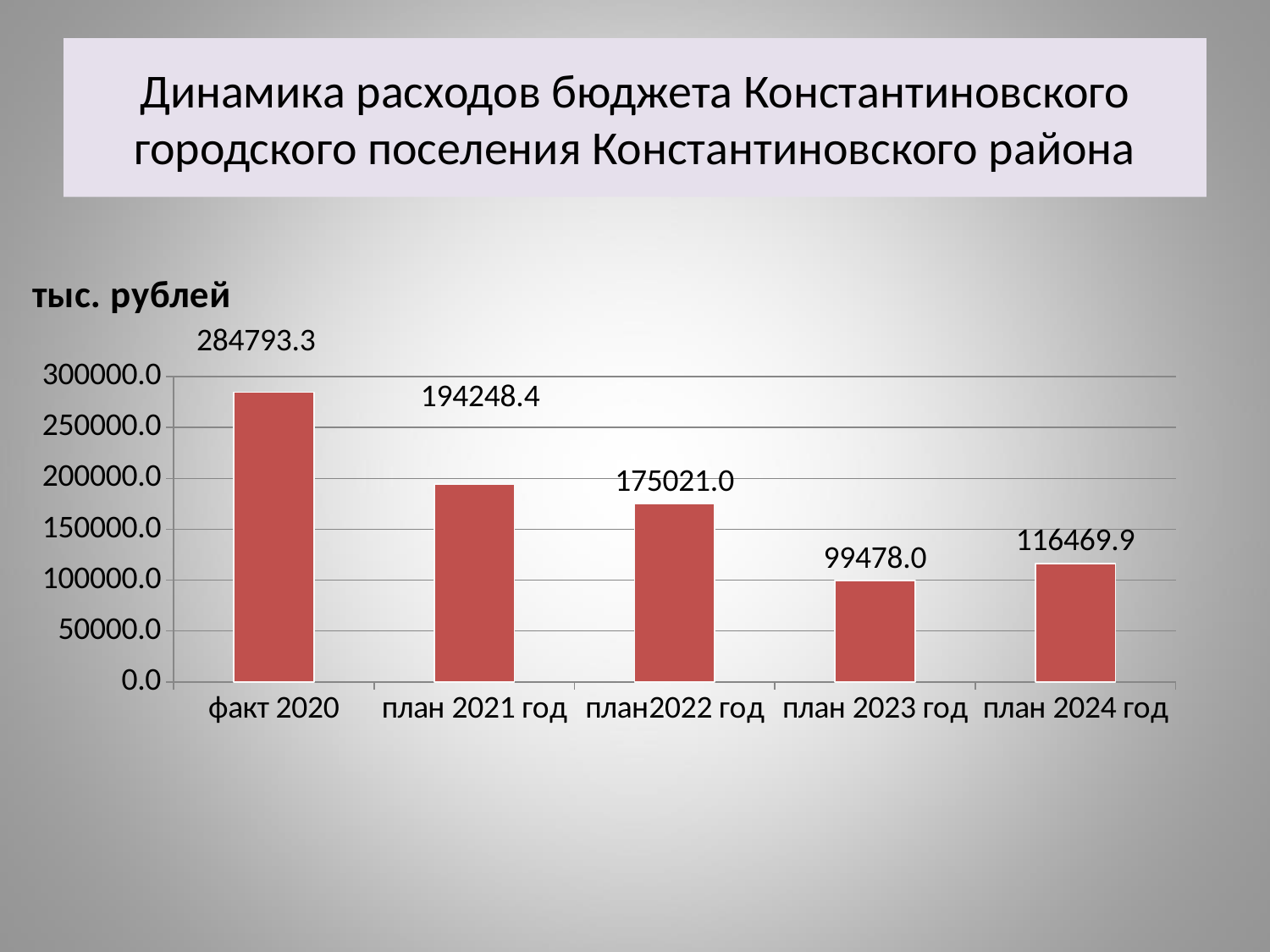
What is the value for факт 2020? 284793.3 Is the value for план 2021 год greater or less than 200000.0? less How many categories are shown on the x axis? 5 Do the values rise or fall from факт 2020 to план 2023 год? fall Which is larger, the value for план2022 год or the value for план 2024 год? план2022 год Which category has the lowest value? план 2023 год Which category has the highest value? факт 2020 What kind of chart is shown on the slide? bar chart What is the difference between the values for факт 2020 and план 2021 год? 90544.9 What is the difference between the values for план 2024 год and план 2023 год? 16991.9 What is the value for план 2024 год? 116469.9 What is the value for план 2023 год? 99478.0